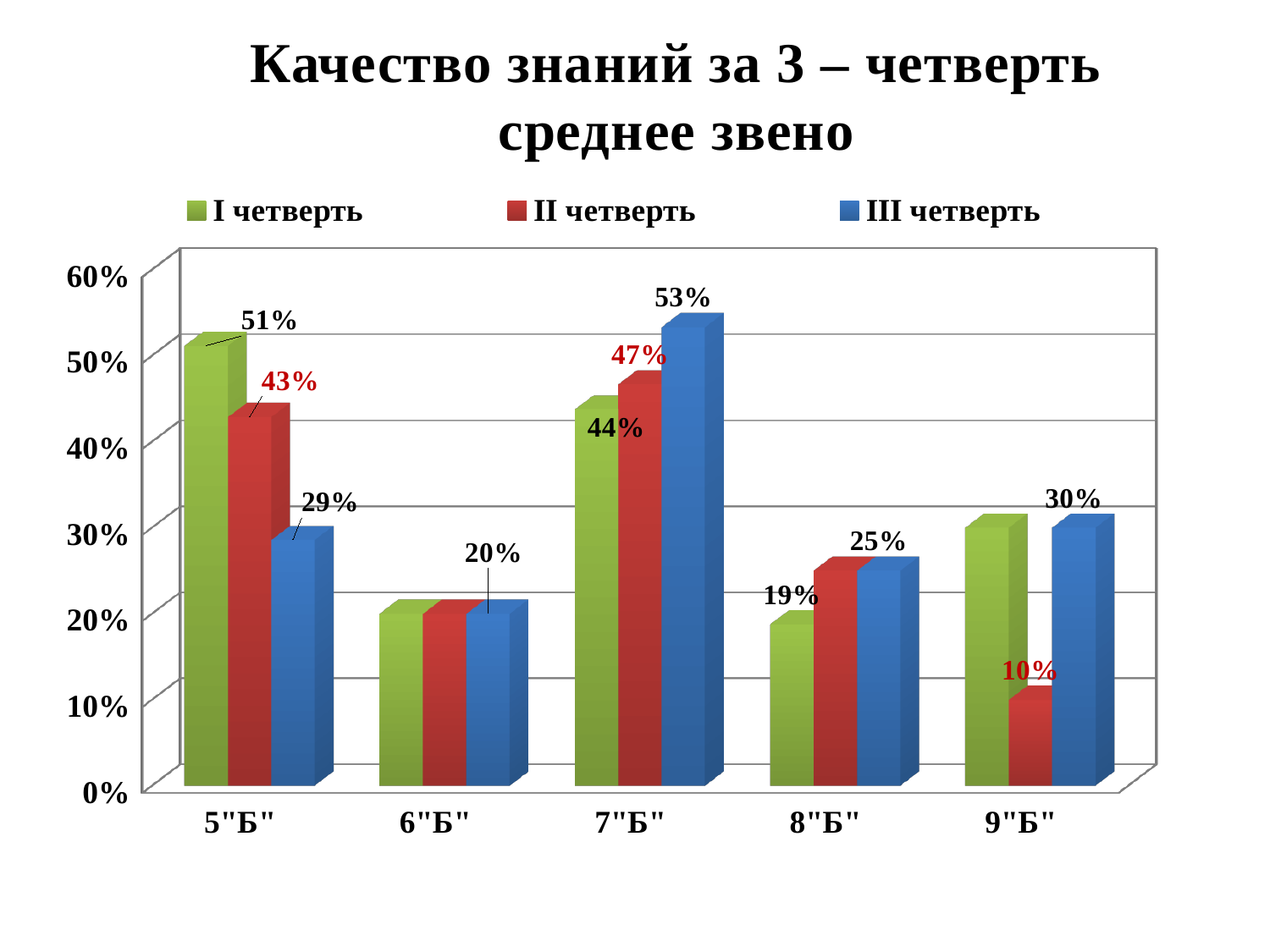
What is the value for 9"Б" in II четверть? 10% What kind of chart is shown on the slide? bar chart How many series does the legend list? 3 Which class has the lowest value in II четверть? 9"Б" How many classes are shown on the x axis? 5 For 5"Б", do the values rise or fall from I четверть to III четверть? fall Is the value for 9"Б" in I четверть greater or less than 20%? greater Which class has the highest value in III четверть? 7"Б" What is the value for 7"Б" in III четверть? 53% What is the difference between the I четверть and III четверть values for 5"Б"? 22 percentage points What is the value for 5"Б" in I четверть? 51% For 7"Б", which is larger: the I четверть value or the II четверть value? II четверть